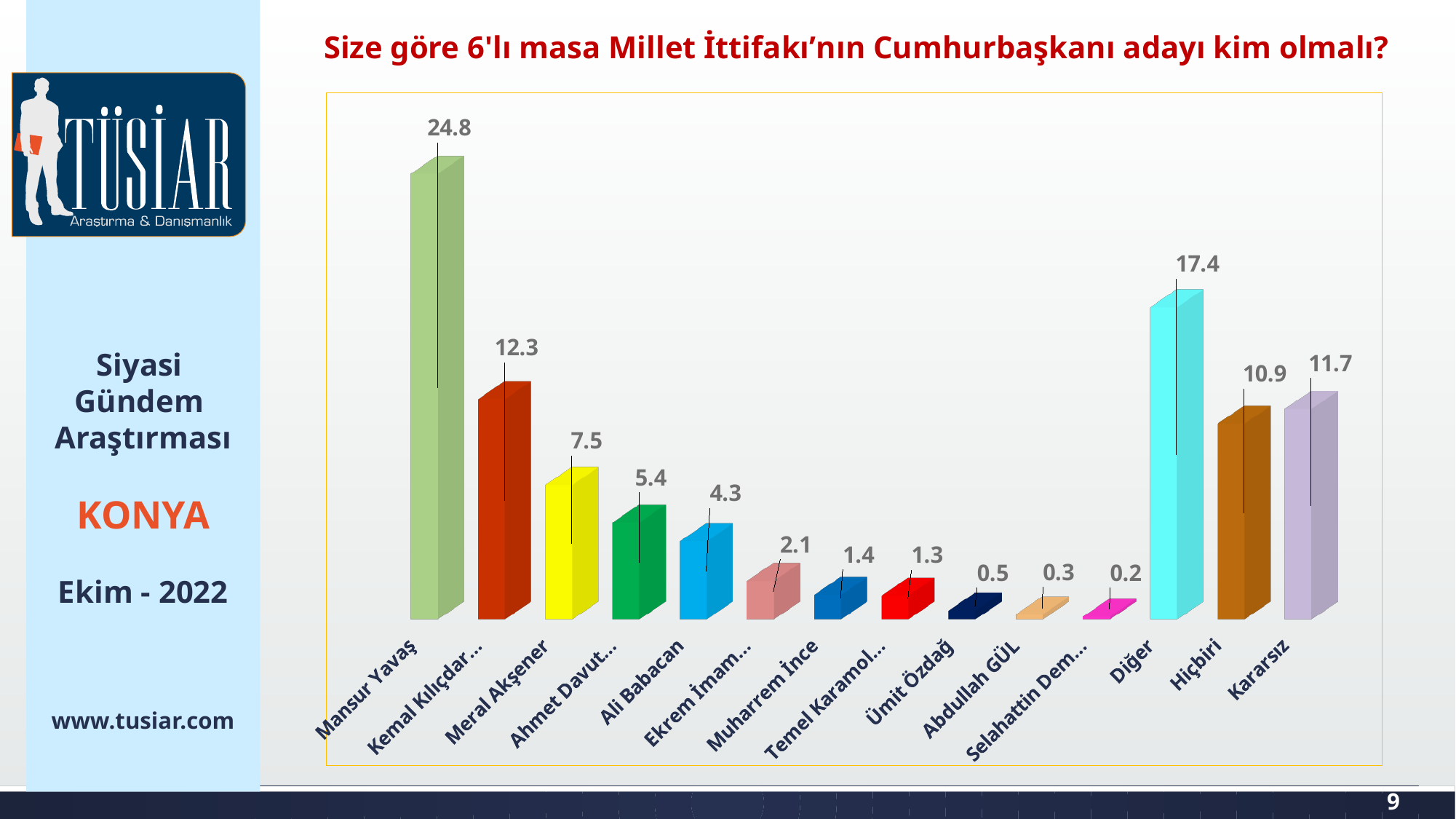
Which is larger, the value for Hiçbiri or the value for Kararsız? Kararsız What value is shown for Diğer? 17.4 How many categories are shown in the chart? 14 What value is shown for Kararsız? 11.7 Which is larger, the value for Meral Akşener or the value for Ali Babacan? Meral Akşener What value is shown for Meral Akşener? 7.5 What value is shown for Abdullah GÜL? 0.3 Which category has the highest value in the chart? Mansur Yavaş What kind of chart is shown on the slide? Bar chart What is the difference between the values for Kararsız and Hiçbiri? 0.8 What value is shown for Mansur Yavaş? 24.8 What is the difference between the values for Mansur Yavaş and Diğer? 7.4